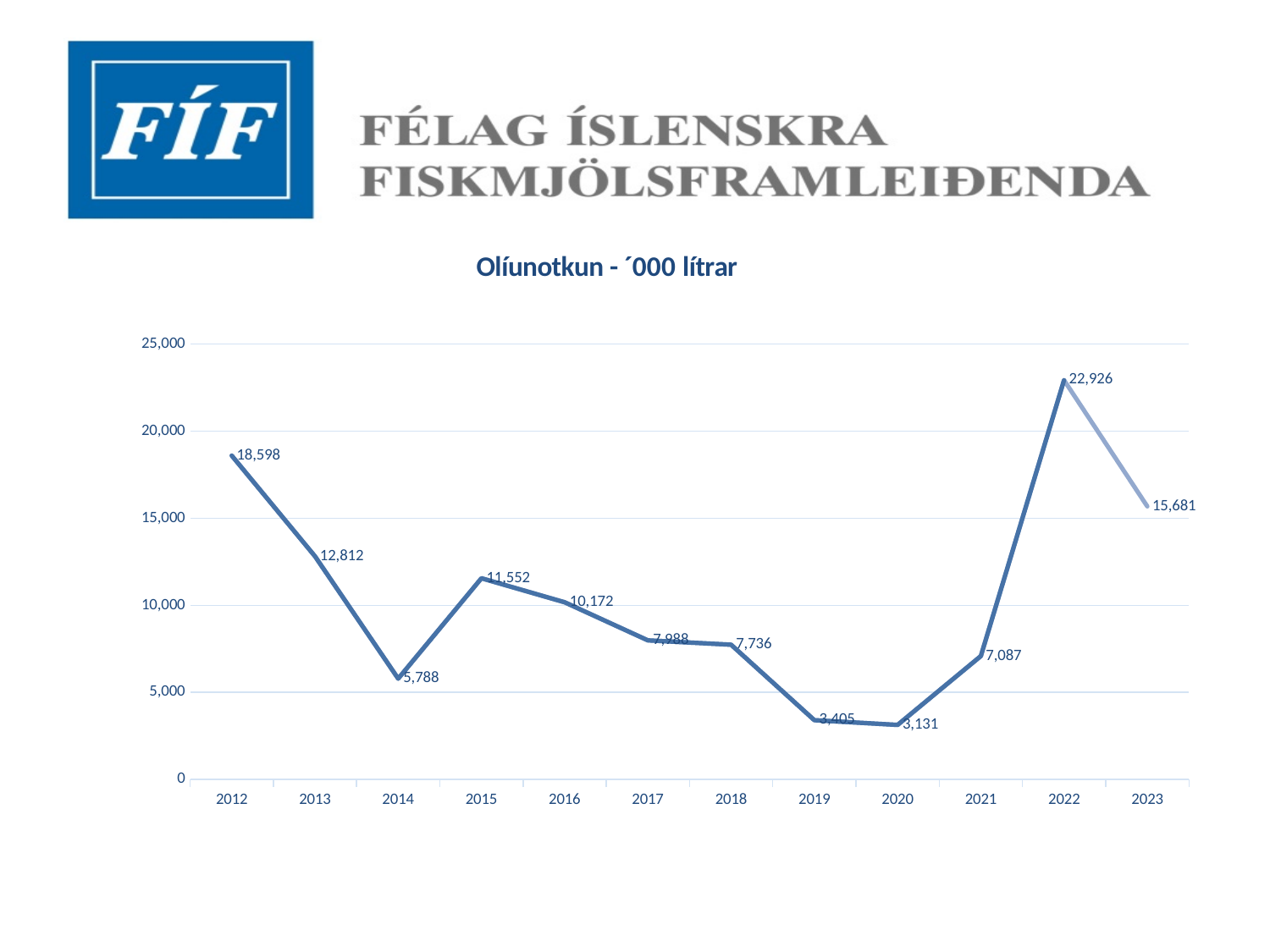
Do the values rise or fall from 2012 to 2014? fall Which year has the lowest value? 2020 What is the value for 2014? 5,788 Which year has the highest value? 2022 Which is larger, the value for 2012 or the value for 2013? 2012 What is the value for 2022? 22,926 What is the title of the chart? Olíunotkun - ´000 lítrar What is the difference between the values for 2022 and 2023? 7,245 How many years are plotted on the chart? 12 Is the value for 2021 greater or less than 10,000? less What kind of chart is shown? line chart What is the value for 2023? 15,681